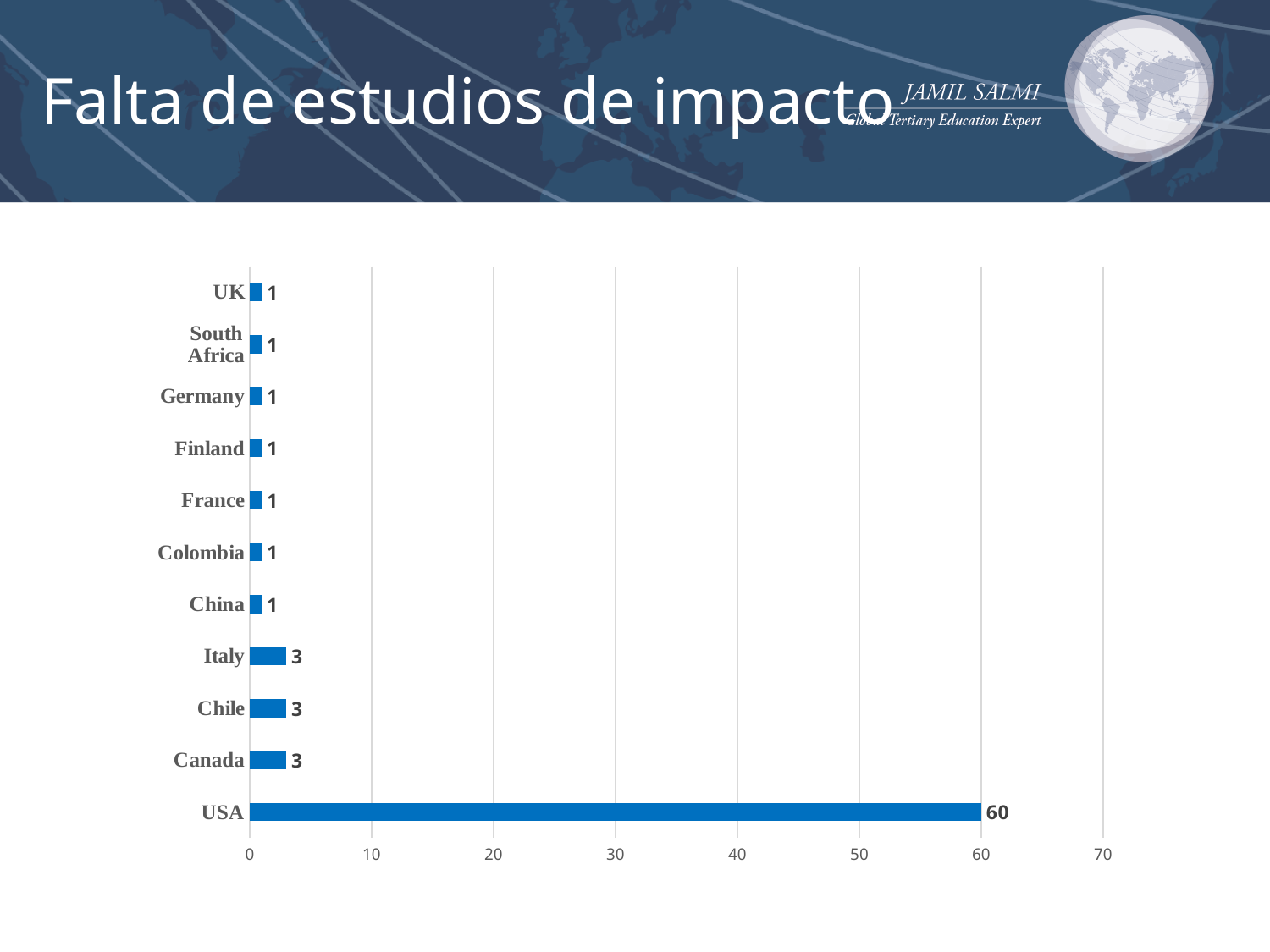
What is the value for Germany? 1 What is the value for Canada? 3 What is the difference between the values for USA and Italy? 57 Is the value for USA greater or less than 50? greater What is the difference between the values for Chile and France? 2 How many countries have a value of 3? 3 What is the value for USA? 60 What is the highest tick value shown on the horizontal axis? 70 What kind of chart is shown on the slide? bar chart How many countries are shown in the chart? 11 Which is larger, the value for Italy or the value for China? Italy Which country has the highest value? USA